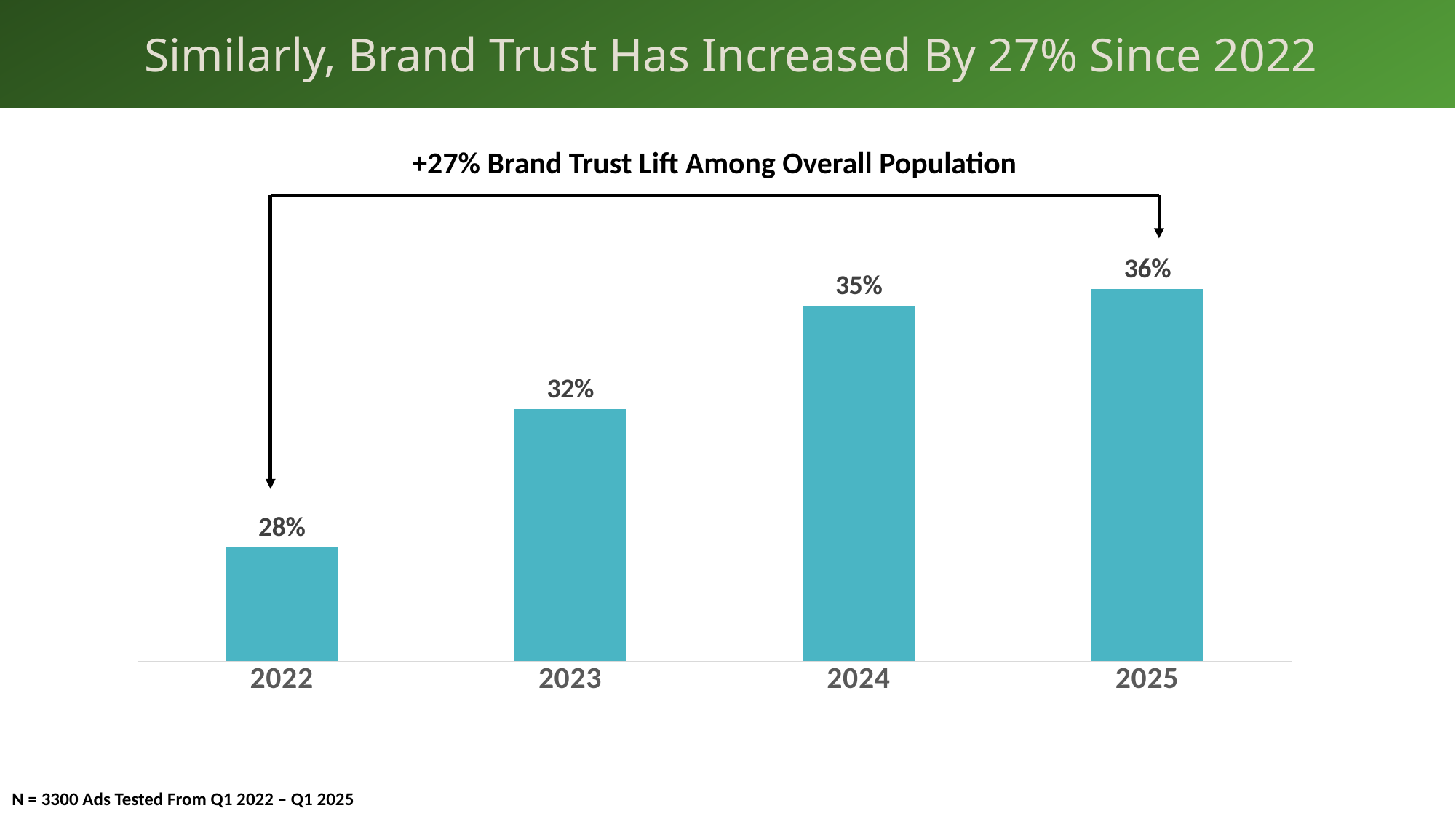
Which year has the lowest brand trust value? 2022 Which year has the highest brand trust value? 2025 What is the difference in percentage points between the 2024 and 2023 values? 3 What kind of chart is shown on the slide? Bar chart Which is larger, the value for 2023 or the value for 2024? 2024 What is the brand trust value for 2025? 36% How many years are shown on the x axis of the chart? 4 What is the brand trust value for 2024? 35% What is the difference in percentage points between the 2025 and 2022 values? 8 What is the brand trust value for 2022? 28% What is the brand trust value for 2023? 32% Do the values rise or fall from 2022 to 2025? Rise